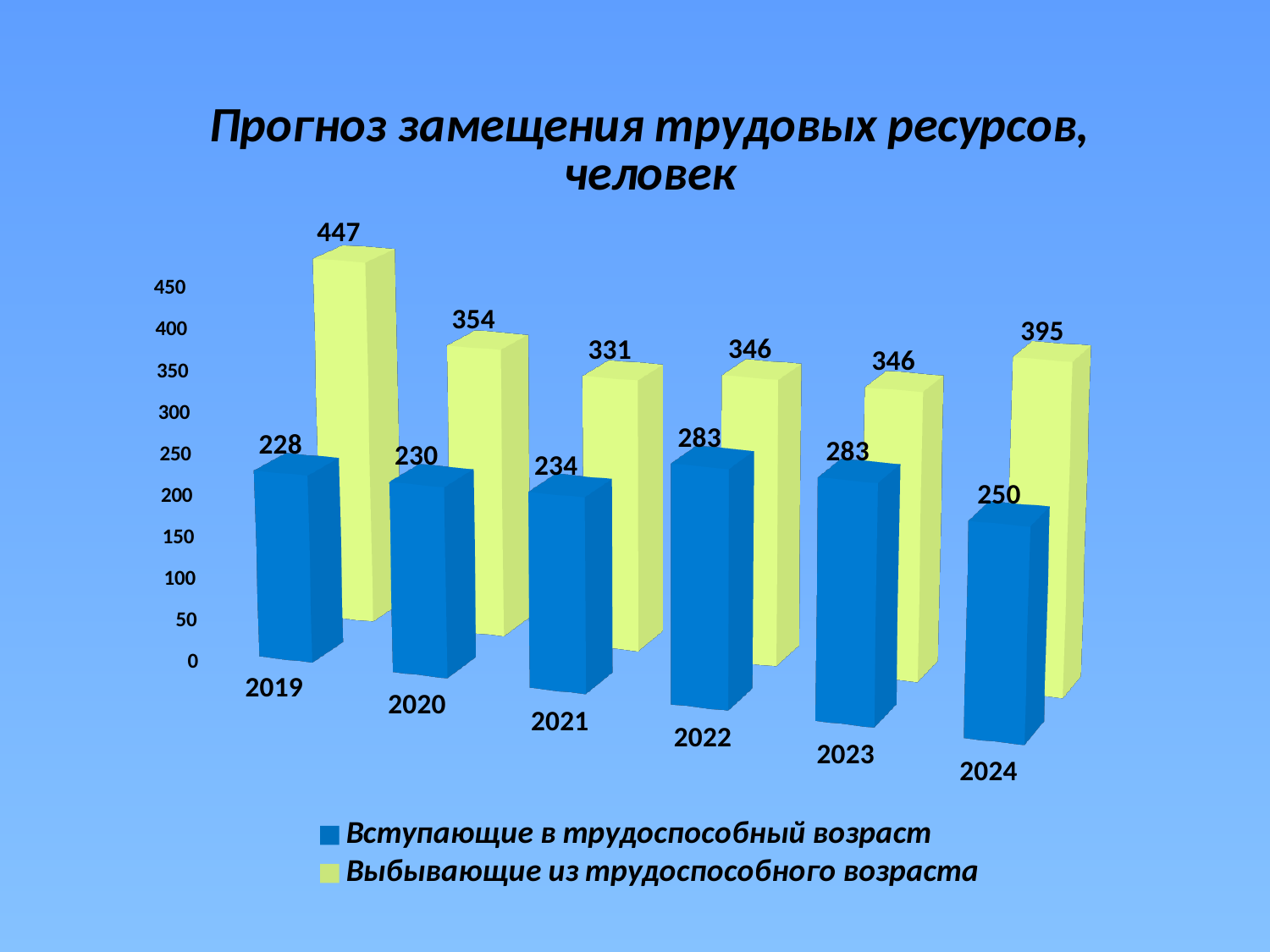
What is the value for "Вступающие в трудоспособный возраст" in 2019? 228 In which year is "Выбывающие из трудоспособного возраста" highest? 2019 What is the title of the chart? Прогноз замещения трудовых ресурсов, человек What kind of chart is shown on the slide? Bar chart In which year is "Вступающие в трудоспособный возраст" lowest? 2019 What is the value for "Вступающие в трудоспособный возраст" in 2022? 283 What is the difference between "Выбывающие из трудоспособного возраста" in 2019 and in 2020? 93 What is the value for "Выбывающие из трудоспособного возраста" in 2024? 395 What is the difference between "Выбывающие из трудоспособного возраста" and "Вступающие в трудоспособный возраст" in 2019? 219 How many series does the legend list? 2 Which is larger in 2021: "Вступающие в трудоспособный возраст" or "Выбывающие из трудоспособного возраста"? Выбывающие из трудоспособного возраста How many years are shown on the x axis? 6